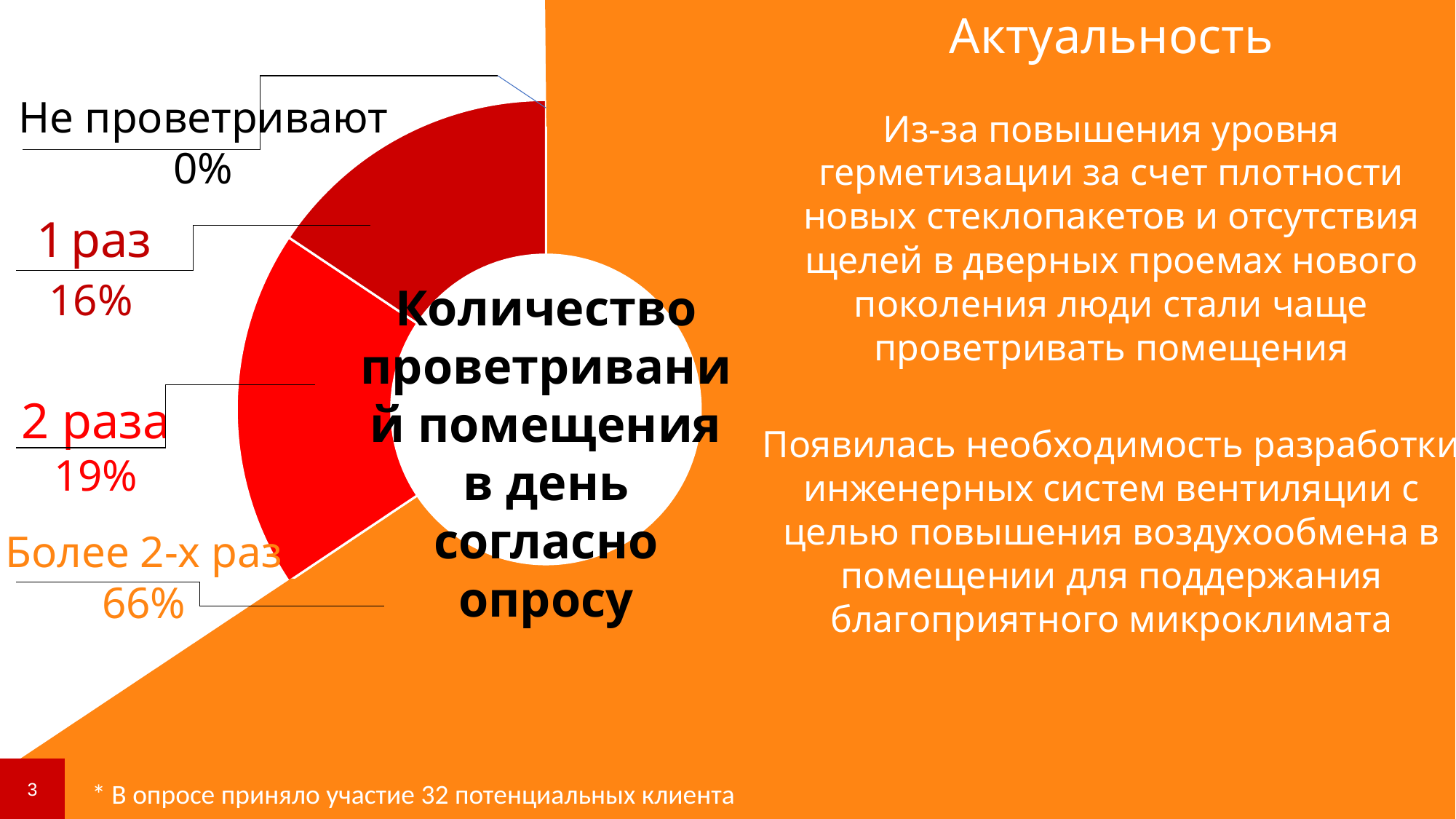
What percentage of respondents do not ventilate the room (Не проветривают)? 0% What is the difference in percentage points between the '2 раза' and '1 раз' categories? 3% How many categories are shown in the chart? 4 What percentage of respondents ventilate the room once a day (1 раз)? 16% Which category has the largest share in the chart? Более 2-х раз What is the title of the chart? Количество проветриваний помещения в день согласно опросу What kind of chart is shown on the slide? Doughnut (pie) chart Which category has the smallest share in the chart? Не проветривают What is the difference in percentage points between 'Более 2-х раз' and '2 раза'? 47% What percentage of respondents ventilate the room twice a day (2 раза)? 19% Which is larger: the share for '1 раз' or the share for '2 раза'? 2 раза What percentage of respondents ventilate the room more than twice a day (Более 2-х раз)? 66%